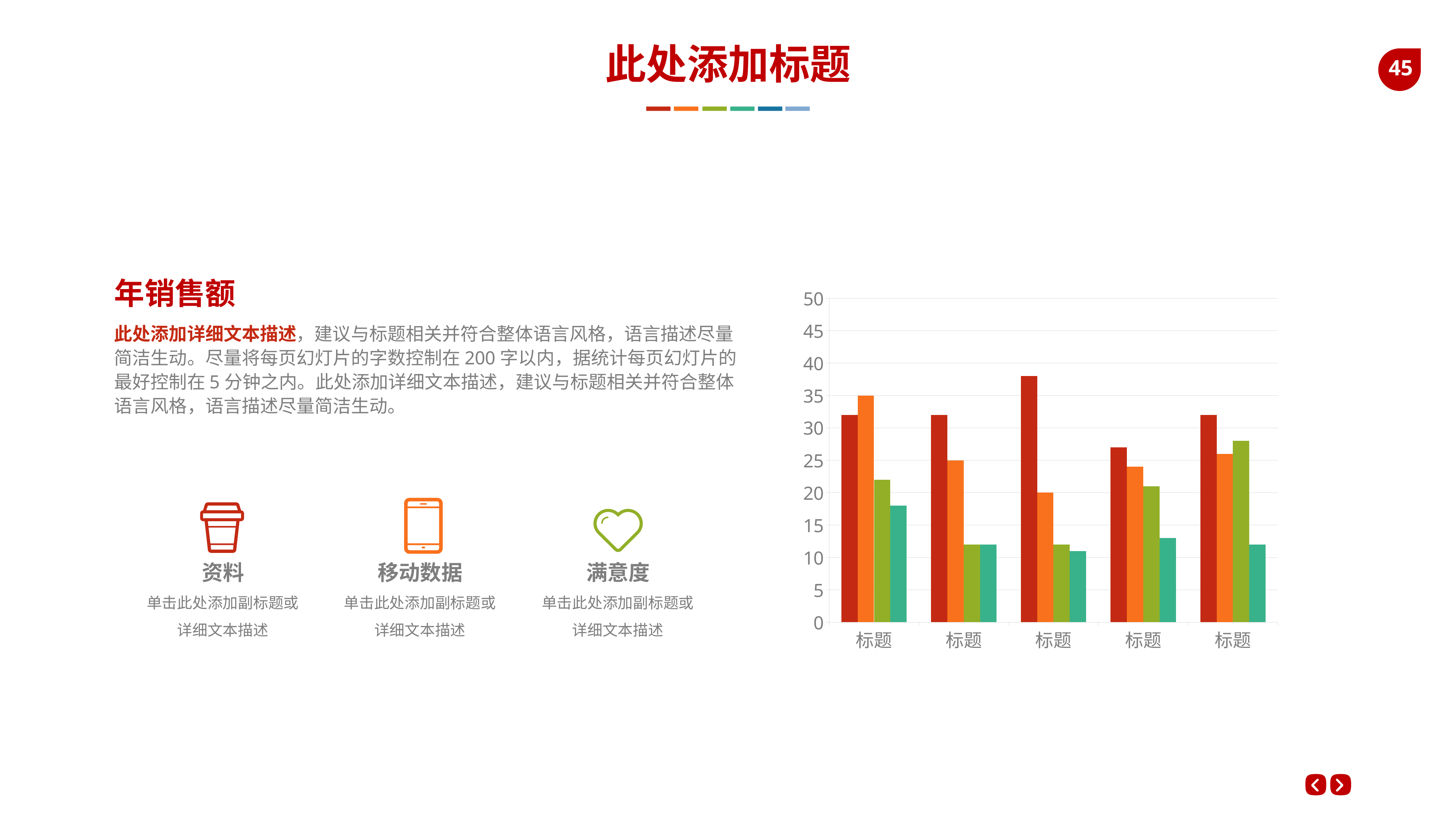
What kind of chart is shown on the slide? bar chart Is the value of the teal bar in the first category group greater or less than 20? less Is the value of the orange bar in the first category group greater or less than 30? greater How many category groups are shown along the x axis of the chart? 5 Is the value of the red bar in the third category group greater or less than 35? greater In the fourth category group, which bar is taller, the red bar or the green bar? red bar How many bars are there in each category group of the chart? 4 In which category group (by position from the left) is the red bar the shortest? fourth What is the highest value shown on the chart's vertical axis? 50 In which category group (by position from the left) is the teal bar the tallest? first In which category group (by position from the left) is the red bar the tallest? third